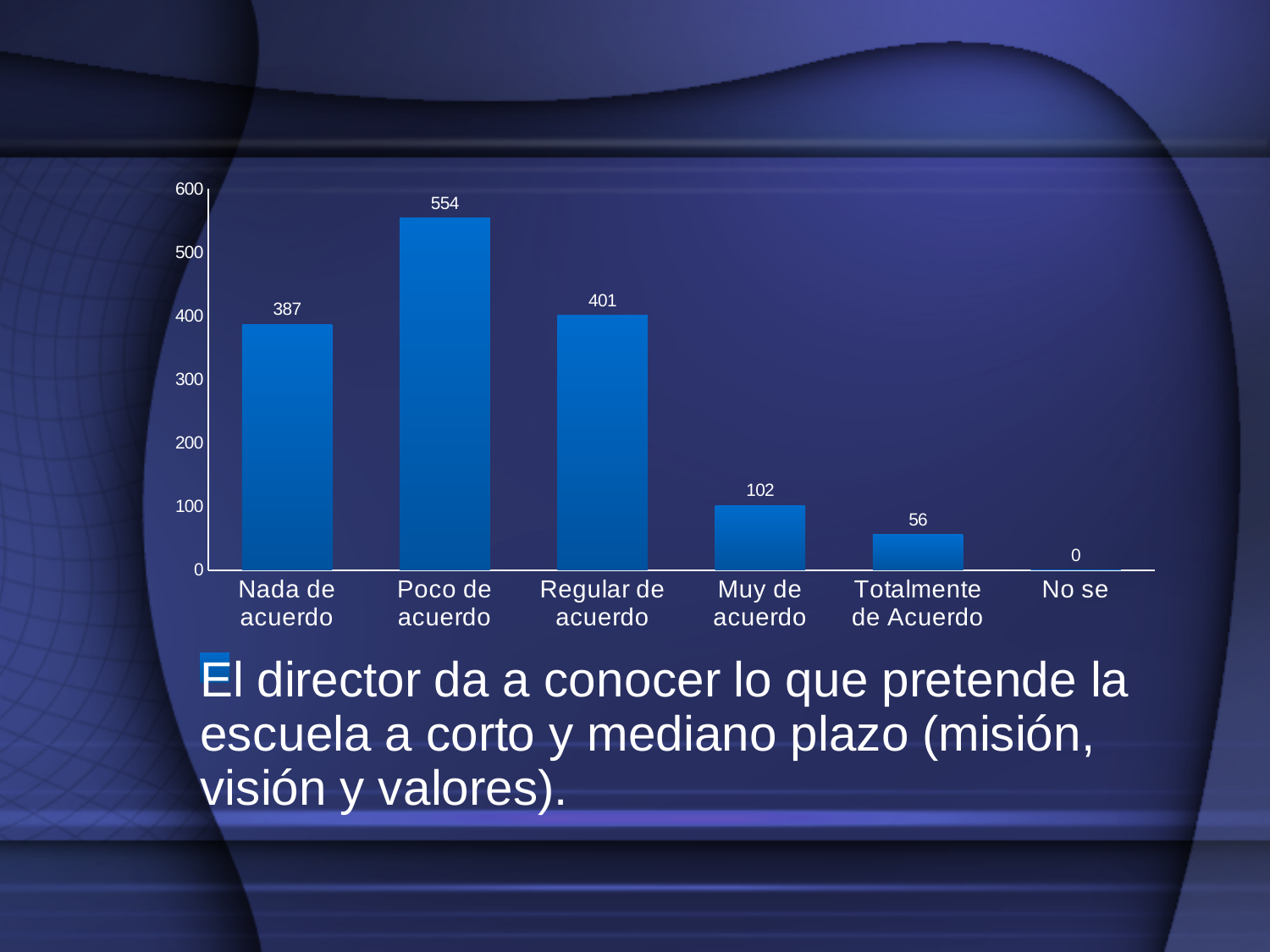
What is the value for "Poco de acuerdo"? 554 What is the value for "No se"? 0 What is the value for "Totalmente de Acuerdo"? 56 How many categories are shown on the x axis? 6 Which is larger, the value for "Nada de acuerdo" or the value for "Regular de acuerdo"? Regular de acuerdo Which category has the lowest value? No se What is the difference between the values for "Muy de acuerdo" and "Totalmente de Acuerdo"? 46 What is the value for "Nada de acuerdo"? 387 Which category has the highest value? Poco de acuerdo What kind of chart is shown on the slide? bar chart What is the difference between the values for "Poco de acuerdo" and "Regular de acuerdo"? 153 Is the value for "Muy de acuerdo" greater or less than 200? less